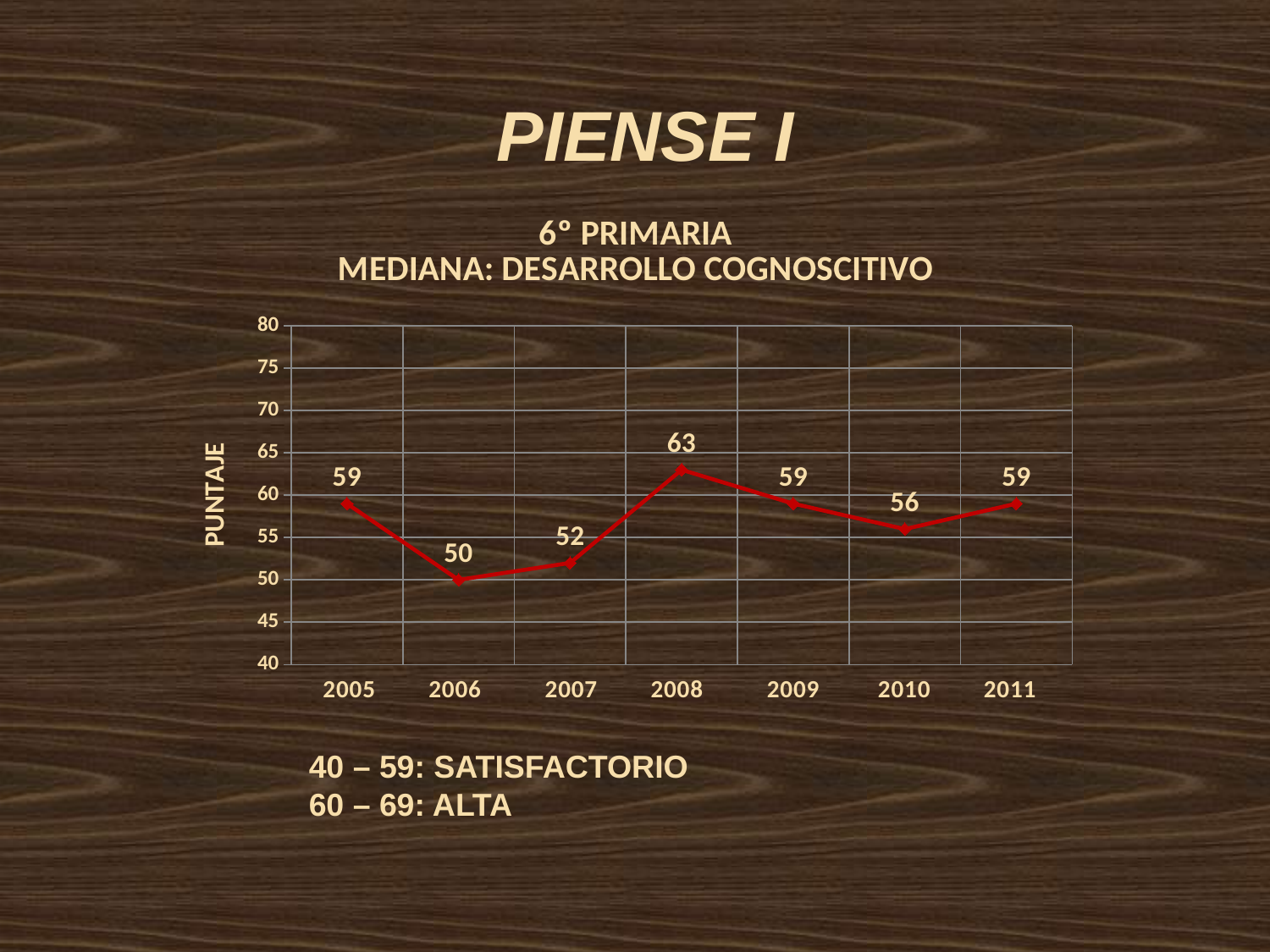
What is the label on the vertical axis? PUNTAJE Which year has the highest value? 2008 What is the difference between the values for 2008 and 2006? 13 What is the value for 2006? 50 What kind of chart is shown? line chart What is the value for 2010? 56 Which is larger, the value for 2007 or the value for 2009? 2009 How many years are plotted on the chart? 7 Which year has the lowest value? 2006 What is the value for 2008? 63 Do the values rise or fall from 2005 to 2006? fall Is the value for 2008 greater or less than 60? greater